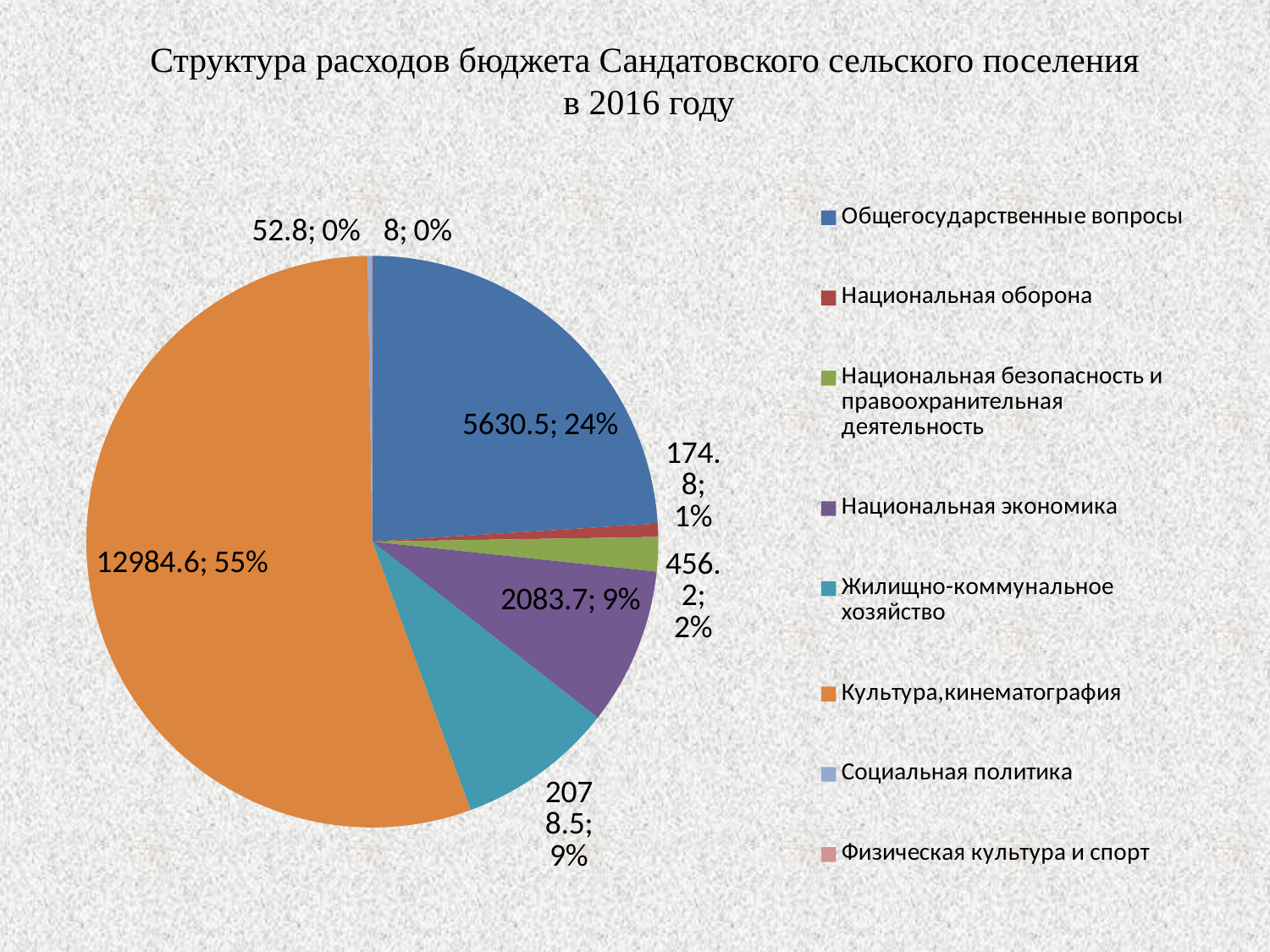
Which category has the smallest value in the pie? Физическая культура и спорт What share of the pie does Культура,кинематография take? 55% Which category has the largest slice of the pie? Культура,кинематография What is the difference between the values for Общегосударственные вопросы and Национальная экономика? 3546.8 What share of the pie does Общегосударственные вопросы take? 24% Which is larger, the value for Национальная безопасность и правоохранительная деятельность or the value for Национальная оборона? Национальная безопасность и правоохранительная деятельность What is the value shown for Национальная экономика? 2083.7 What is the value shown for Общегосударственные вопросы? 5630.5 How many categories does the legend list? 8 What is the value shown for Культура,кинематография? 12984.6 What is the value shown for Национальная оборона? 174.8 What type of chart is shown on the slide? pie chart